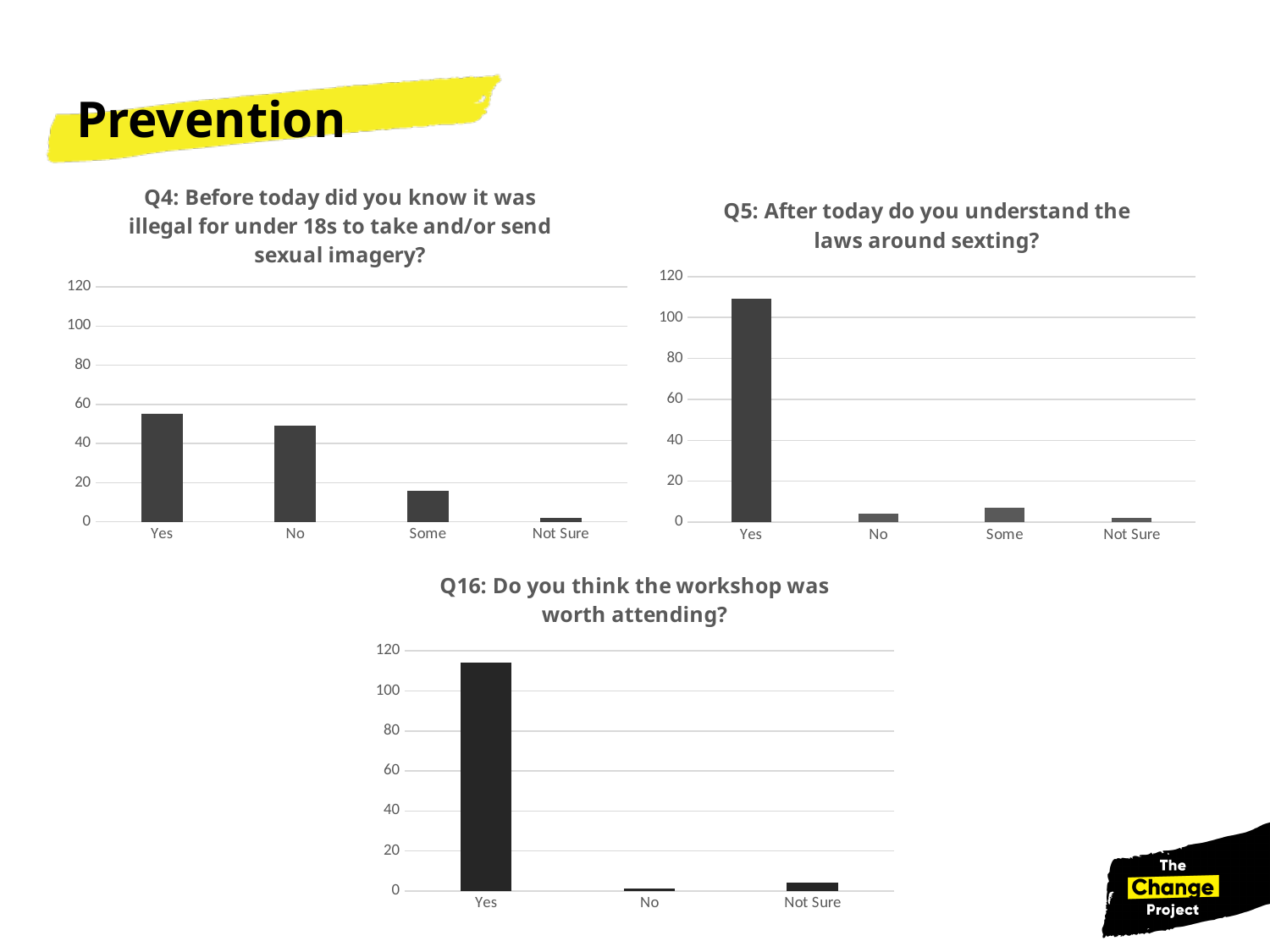
In the Q4 chart (top left), is the value for Some greater or less than 20? less In the Q5 chart (top right), which is larger, the value for Some or the value for No? Some In the Q4 chart (top left), which category has the lowest value? Not Sure In the Q4 chart (top left), how many categories are shown on the x axis? 4 In the Q16 chart (bottom), how many categories are shown on the x axis? 3 In the Q16 chart (bottom), which category has the lowest value? No In the Q5 chart (top right), is the value for Yes greater or less than 100? greater What is the title of the chart at the top right of the slide? Q5: After today do you understand the laws around sexting? In the Q16 chart (bottom), which category has the highest value? Yes What kind of chart is the Q16 chart at the bottom of the slide? Bar chart In the Q4 chart (top left), is the value for Yes greater or less than 40? greater In the Q5 chart (top right), which category has the highest value? Yes